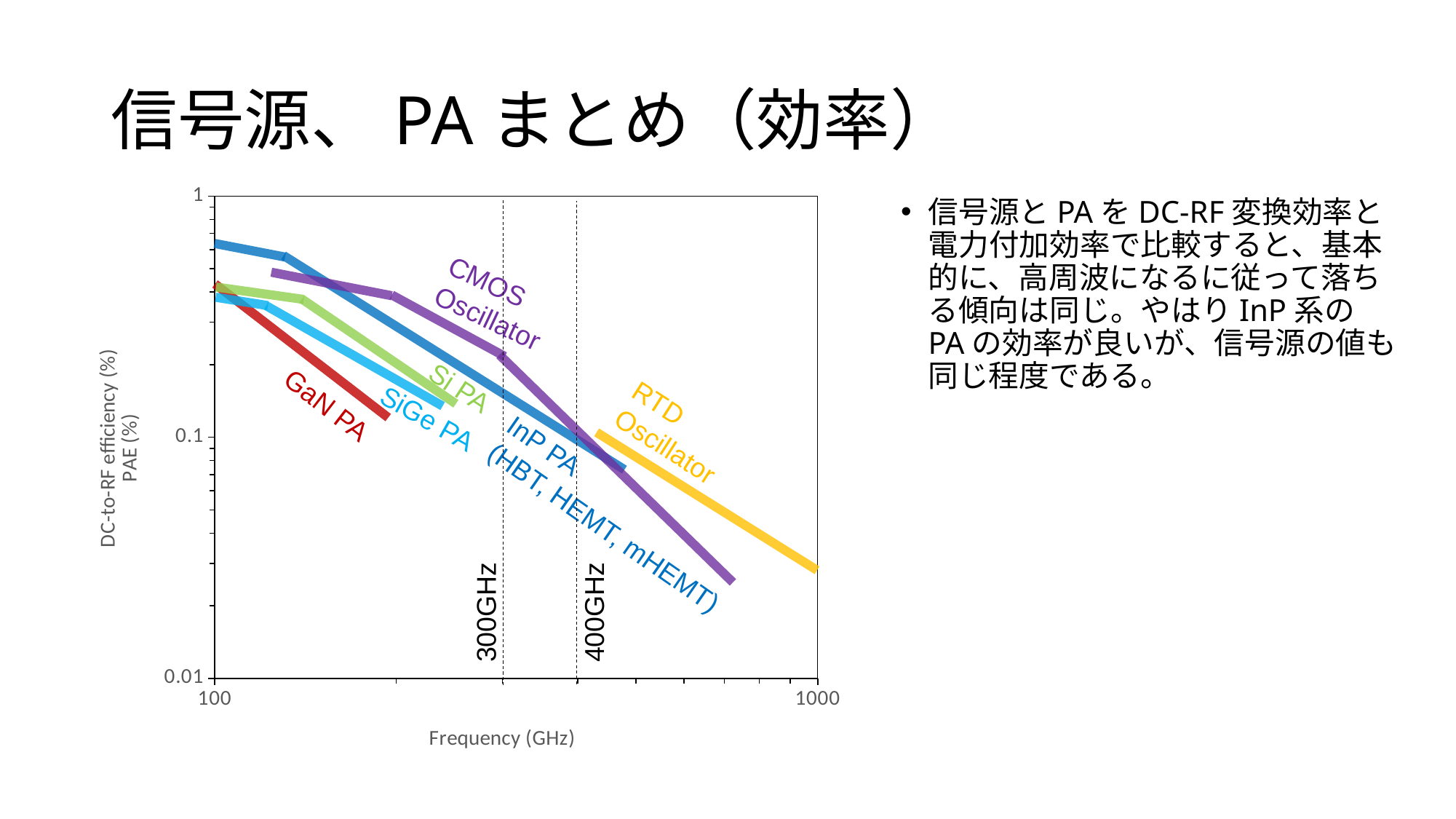
Which series ends at the lowest frequency on the chart? GaN PA Is the value for the InP PA at 100 GHz greater or less than 0.1? greater At which two frequencies are vertical dashed reference lines drawn? 300GHz and 400GHz Is the value for the CMOS Oscillator at 300 GHz greater or less than 0.1? greater How many labelled series (lines) are plotted on the chart? 6 Which series has the highest efficiency at 100 GHz? InP PA (HBT, HEMT, mHEMT) Is the value for the RTD Oscillator at 1000 GHz greater or less than 0.1? less What is the label of the x axis? Frequency (GHz) At 100 GHz, which is larger: the value for the InP PA or the value for the GaN PA? InP PA What kind of chart is shown on the slide? line chart Do the efficiency values rise or fall as frequency increases along the x axis? fall Which series extends to the highest frequency on the chart? RTD Oscillator